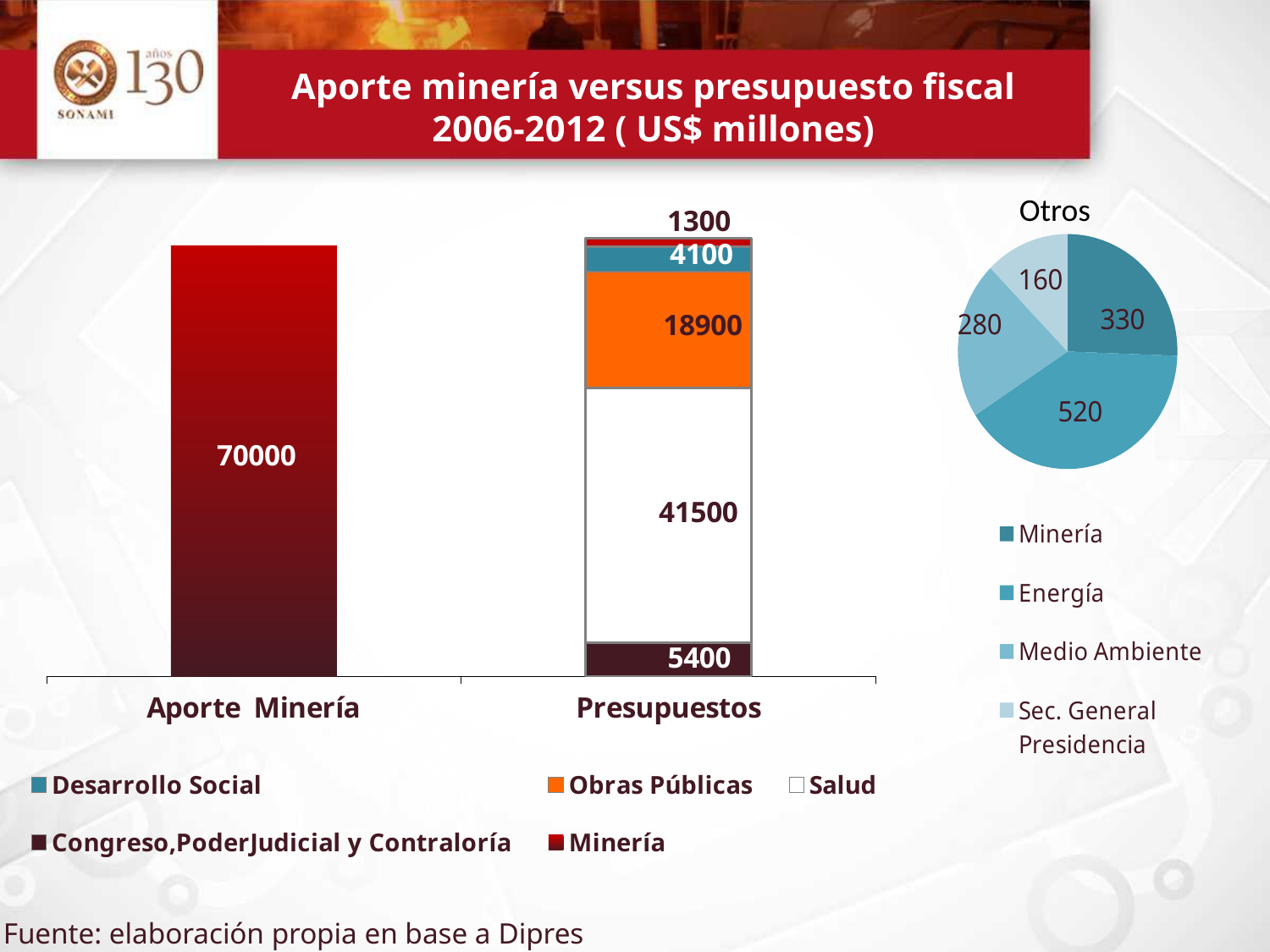
In the bar chart, what is the difference between the Salud segment and the Obras Públicas segment in the Presupuestos bar? 22600 What kind of chart is the chart on the left of the slide? Stacked bar chart In the bar chart, how many series does the legend list? 5 In the Otros pie chart, how many categories are shown? 4 In the bar chart, what is the value of the Obras Públicas segment in the Presupuestos bar? 18900 In the Otros pie chart, what is the difference between the Minería and Medio Ambiente values? 50 In the bar chart, what is the value of the Aporte Minería bar? 70000 In the Otros pie chart, which category has the smallest slice? Sec. General Presidencia In the bar chart, what is the value of the Salud segment in the Presupuestos bar? 41500 In the bar chart, what is the total of the stacked Presupuestos bar? 71200 In the Otros pie chart, what is the value for Energía? 520